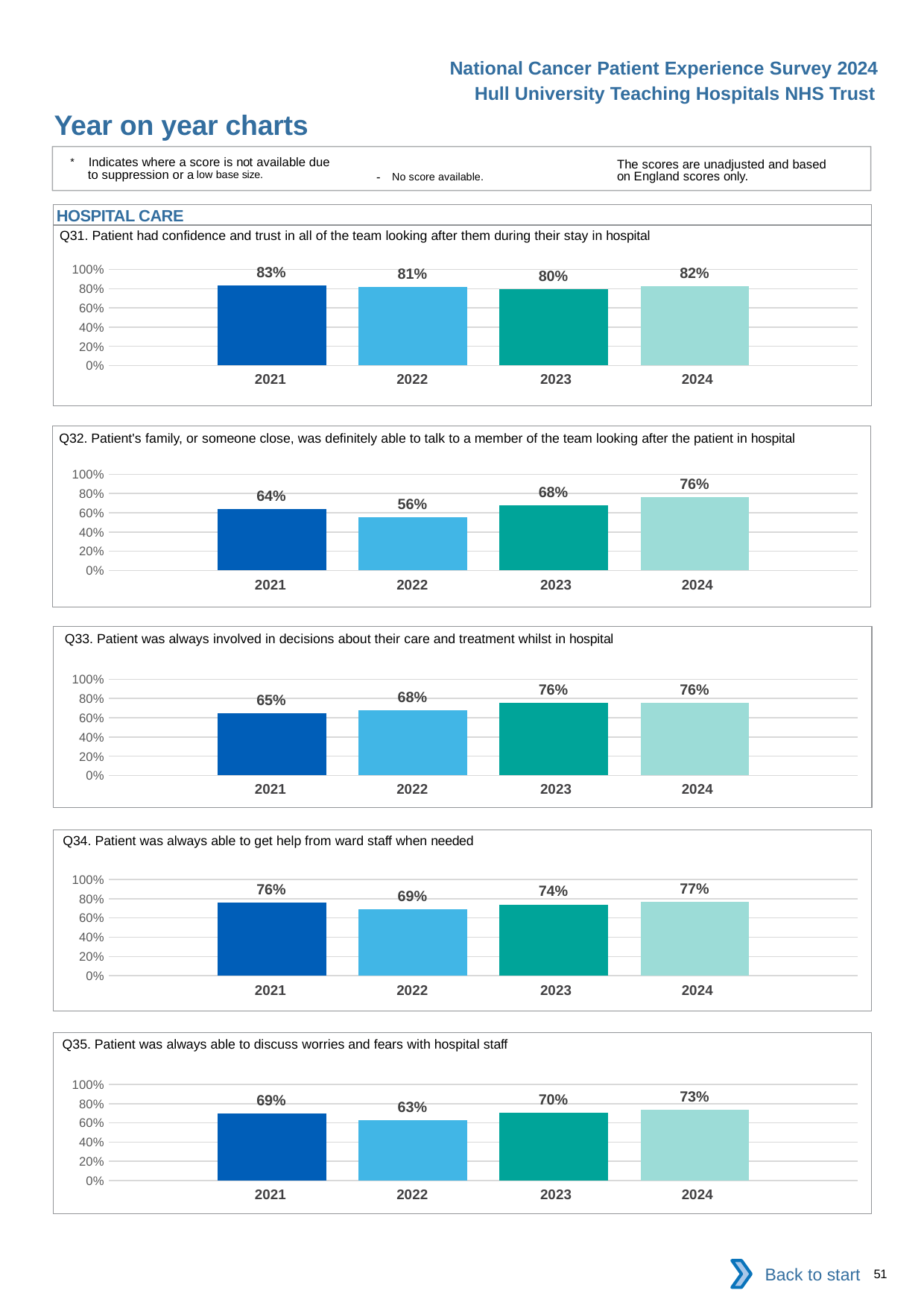
In the Q34 chart, which is larger, the value for 2021 or the value for 2023? 2021 How many years are shown on the x axis of the Q34 chart? 4 In the Q33 chart, do the values rise or fall from 2021 to 2023? rise In the Q35 chart, is the value for 2022 greater or less than 80%? less In the Q34 chart, what is the difference between the 2024 value and the 2022 value? 8% In the Q32 chart, which year has the lowest value? 2022 What kind of chart is the Q31 chart? bar chart In the Q35 chart, what is the value for 2024? 73% In the Q32 chart, which year has the highest value? 2024 What is the section heading above the Q31 chart? HOSPITAL CARE In the Q31 chart, what is the value for 2021? 83% In the Q33 chart, what is the difference between the 2024 value and the 2021 value? 11%